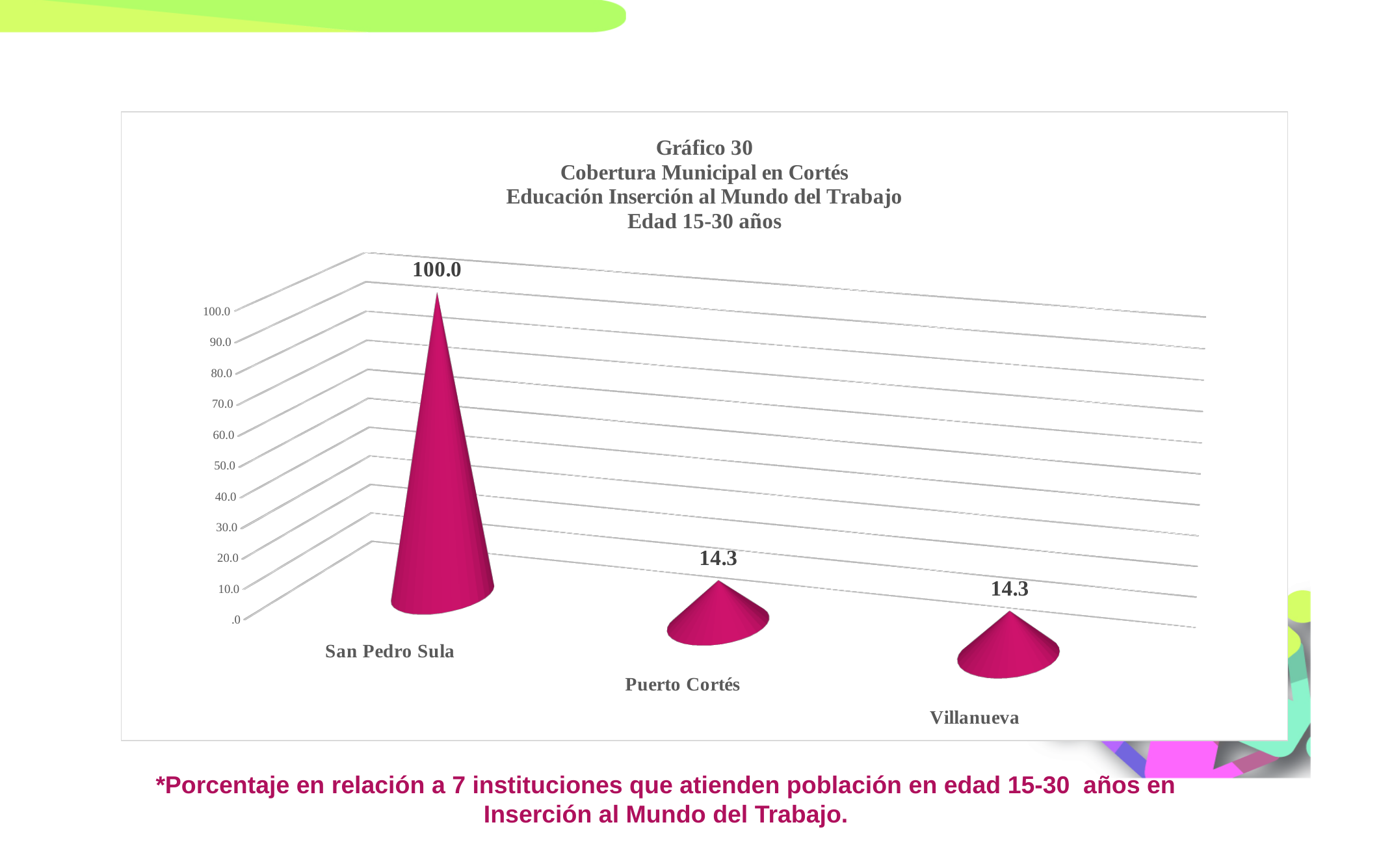
Which municipality has the highest value? San Pedro Sula Do the values for Puerto Cortés and Villanueva differ? No What is the difference between the values for San Pedro Sula and Puerto Cortés? 85.7 Is the value for Puerto Cortés greater or less than 50.0? less What age range is given in the chart title? 15-30 años What is the value for San Pedro Sula? 100.0 How many municipalities are shown on the chart? 3 What is the highest value shown on the vertical axis? 100.0 What is the value for Puerto Cortés? 14.3 What kind of chart is shown on the slide? bar chart Which is larger, the value for San Pedro Sula or the value for Villanueva? San Pedro Sula What is the value for Villanueva? 14.3